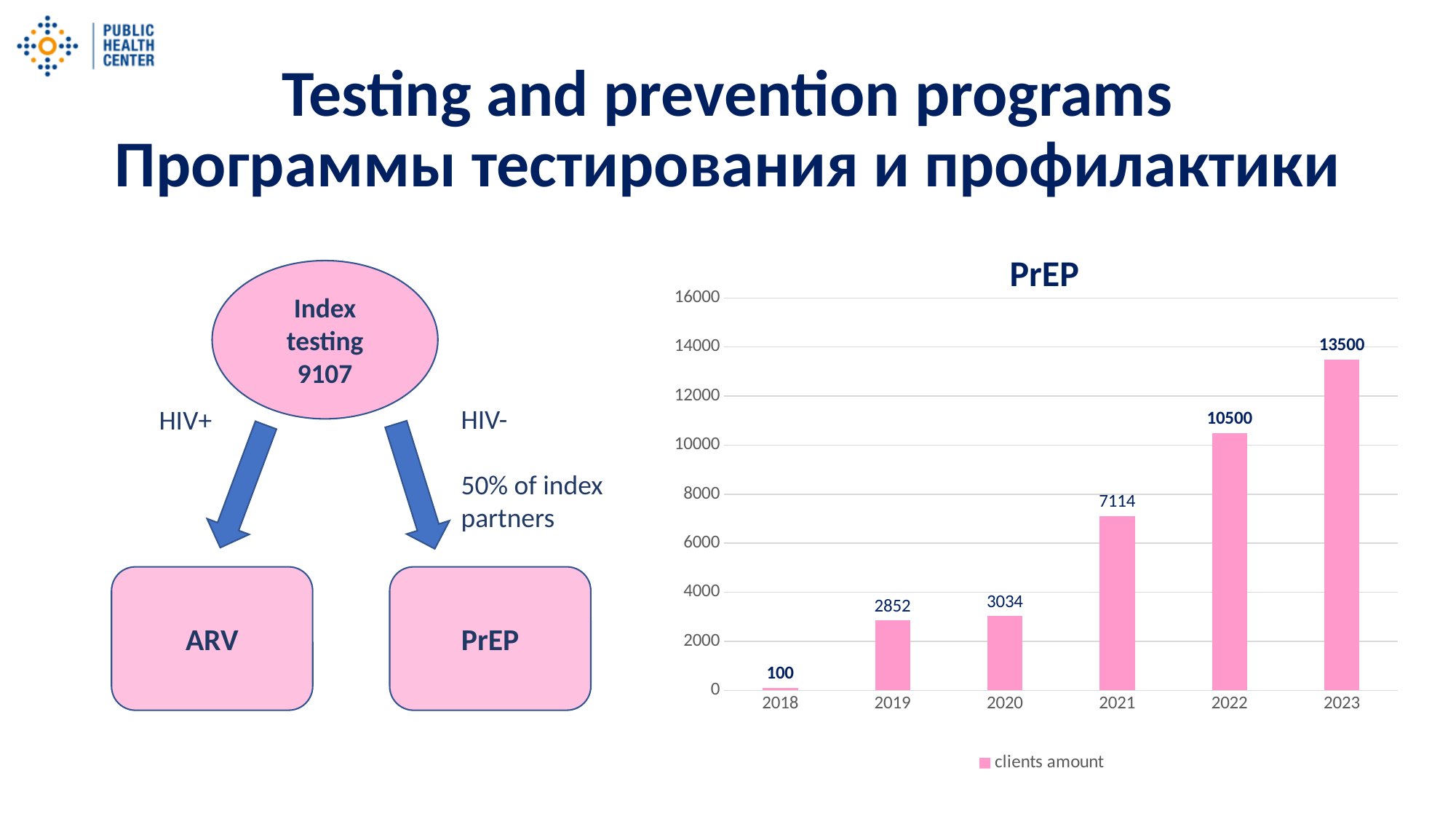
Does the clients amount in the PrEP chart rise or fall from 2018 to 2023? rise What is the clients amount for 2023 in the PrEP chart? 13500 How many years are shown on the x axis of the PrEP chart? 6 Is the clients amount for 2022 in the PrEP chart greater or less than 10000? greater What is the difference in clients amount between 2020 and 2019 in the PrEP chart? 182 In the PrEP chart, which year has a larger clients amount, 2020 or 2021? 2021 What is the clients amount for 2019 in the PrEP chart? 2852 What is the clients amount for 2021 in the PrEP chart? 7114 Which year has the highest clients amount in the PrEP chart? 2023 What is the difference in clients amount between 2023 and 2022 in the PrEP chart? 3000 What type of chart is the PrEP chart? bar chart Which year has the lowest clients amount in the PrEP chart? 2018